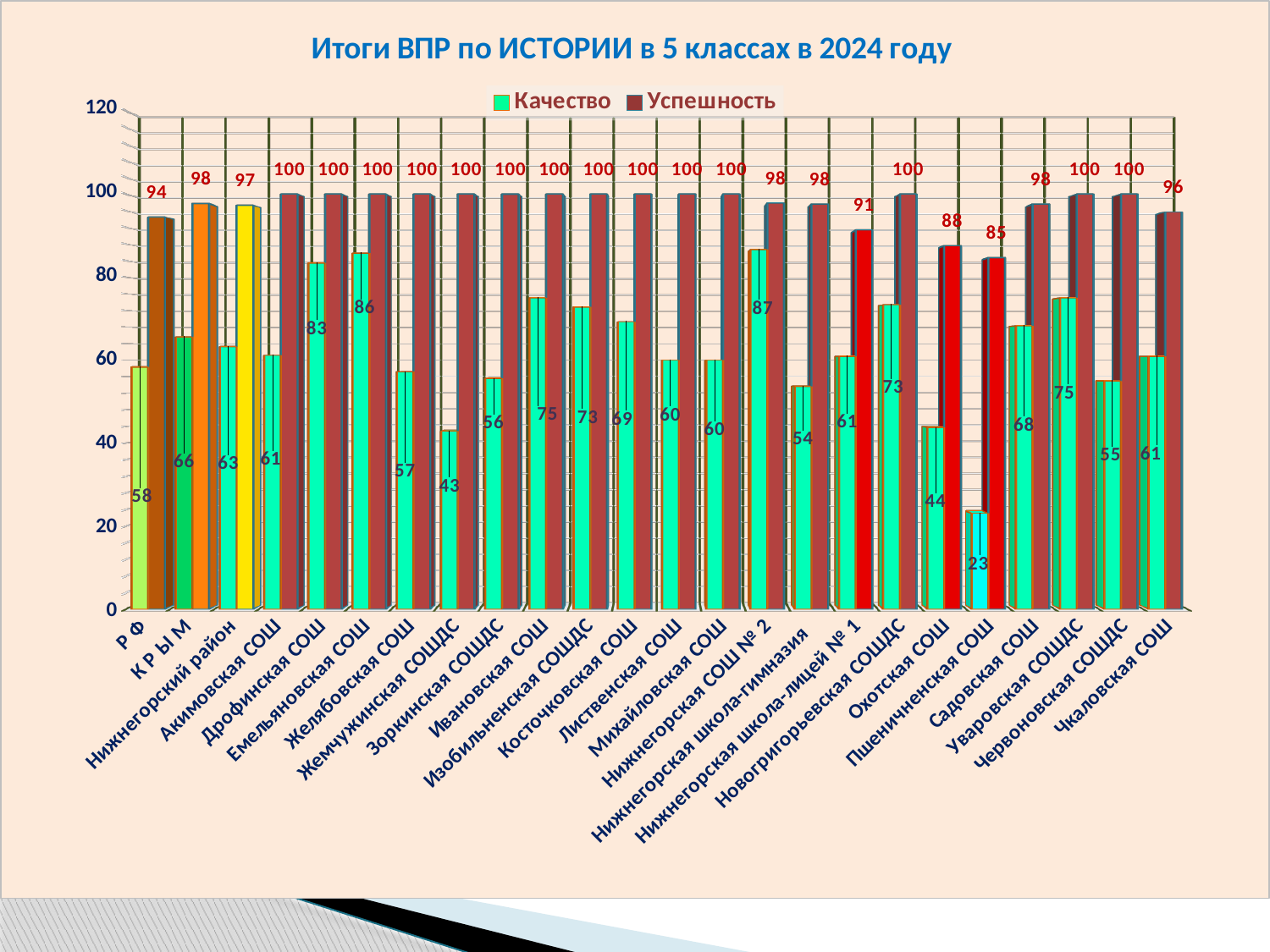
What kind of chart is shown on the slide? Bar chart What is the Успешность value for РФ? 94 Which is larger: the Качество value for Емельяновская СОШ or for Ивановская СОШ? Емельяновская СОШ How many series does the legend list? 2 What is the difference between the Успешность and Качество values for Жемчужинская СОШДС? 57 Which category has the lowest Успешность value? Пшеничненская СОШ What is the title of the chart? Итоги ВПР по ИСТОРИИ в 5 классах в 2024 году Which category has the highest Качество value? Нижнегорская СОШ № 2 What is the Качество value for Дрофинская СОШ? 83 What is the Успешность value for Охотская СОШ? 88 How many categories are shown on the x axis? 24 What is the Качество value for Пшеничненская СОШ? 23